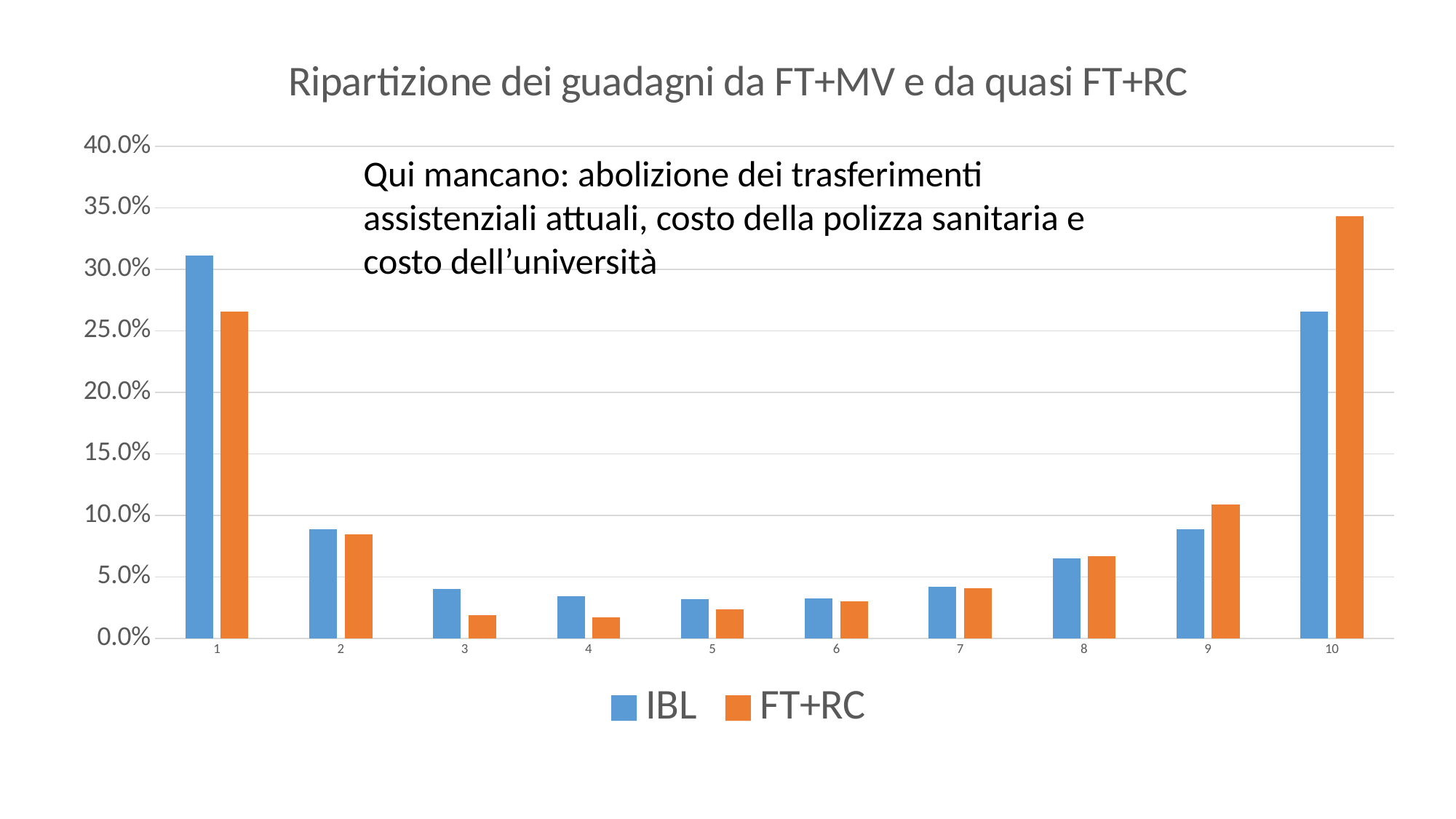
What is the title of the chart? Ripartizione dei guadagni da FT+MV e da quasi FT+RC Which category has the highest FT+RC value? 10 For category 3, which series has the larger value, IBL or FT+RC? IBL For category 10, which series has the larger value, IBL or FT+RC? FT+RC Is the FT+RC value for category 9 greater or less than 10.0%? greater Is the IBL value for category 2 greater or less than 10.0%? less For category 1, which series has the larger value, IBL or FT+RC? IBL Which category has the highest IBL value? 1 How many series does the legend list? 2 What kind of chart is shown on the slide? bar chart How many categories are shown on the x axis? 10 Is the IBL value for category 1 greater or less than 30.0%? greater